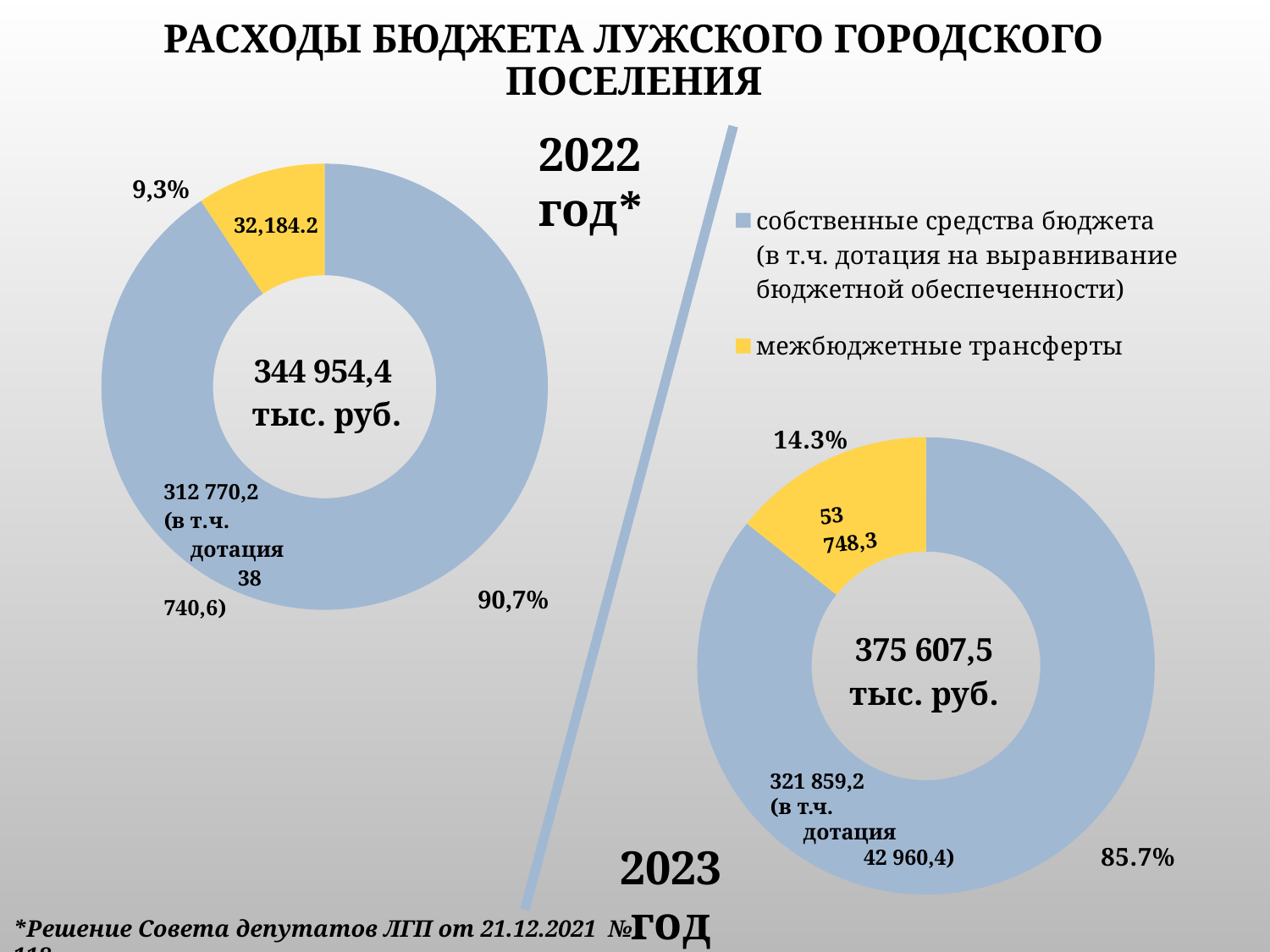
What kind of chart is used for the 2022 budget on the slide? Pie (donut) chart In the 2023 chart, which category has the largest share? собственные средства бюджета In the 2022 chart, what share of the budget is собственные средства бюджета? 90,7% In the 2023 chart, what share of the budget is собственные средства бюджета? 85.7% In the 2022 chart, what is the value for межбюджетные трансферты? 32,184.2 How many entries does the legend list? 2 What total is shown in the centre of the 2023 chart? 375 607,5 тыс. руб. In the 2023 chart, what is the value for межбюджетные трансферты? 53 748,3 What total is shown in the centre of the 2022 chart? 344 954,4 тыс. руб. In the 2022 chart, what share of the budget is межбюджетные трансферты? 9,3% In the 2022 chart, what is the value for собственные средства бюджета? 312 770,2